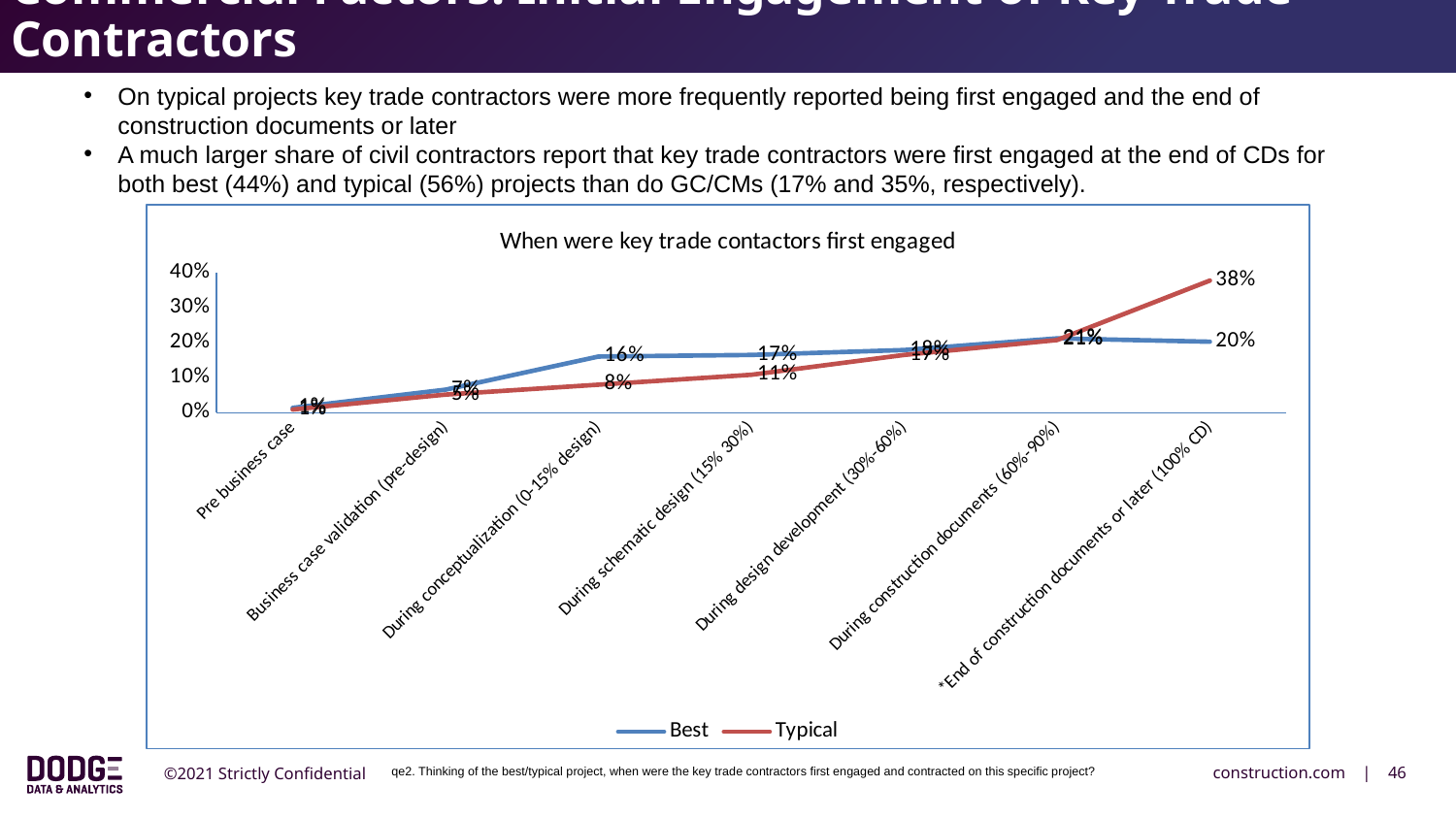
What is the Typical value for '*End of construction documents or later (100% CD)'? 38% For 'During schematic design (15%-30%)', which series has the larger value, Best or Typical? Best Which category has the highest Typical value? *End of construction documents or later (100% CD) Does the Typical series generally rise or fall from left to right along the x axis? Rise How many categories are plotted along the x axis of the chart? 7 What is the Typical value for 'During conceptualization (0-15% design)'? 8% How many series does the chart's legend list? 2 What is the difference between the Typical and Best values for '*End of construction documents or later (100% CD)'? 18 percentage points What is the title of the chart? When were key trade contactors first engaged What is the Best value for 'During conceptualization (0-15% design)'? 16% What kind of chart is shown on the slide? Line chart What is the Best value for '*End of construction documents or later (100% CD)'? 20%